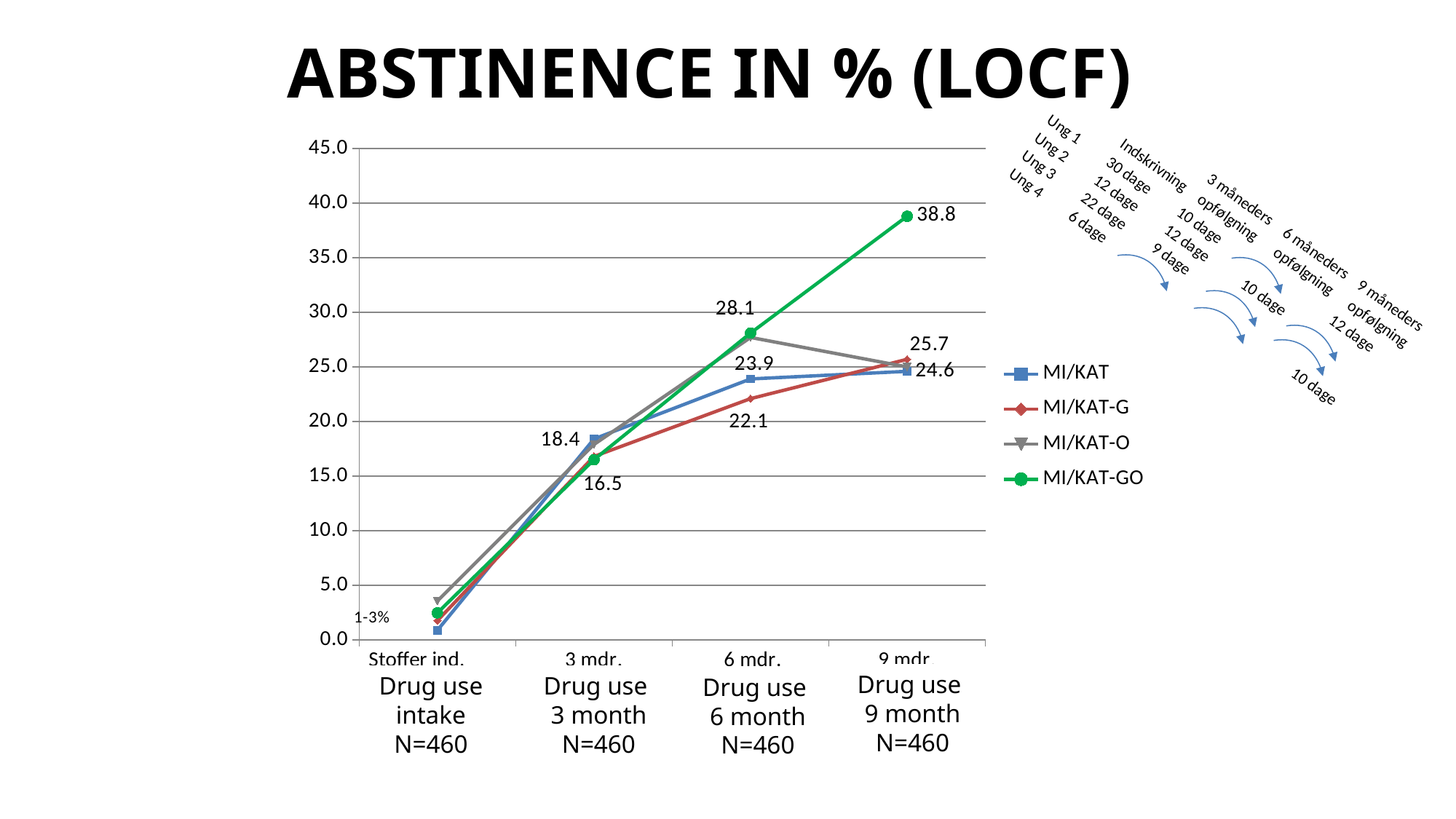
What kind of chart is shown on the slide? line chart Does the MI/KAT-GO series rise or fall from intake to 9 month? rise How many series does the legend list? 4 Is the value for MI/KAT-GO at Drug use 9 month greater or less than 35.0? greater Which series has the highest value at Drug use 9 month? MI/KAT-GO How many time points are plotted along the x axis? 4 What is the value for MI/KAT-GO at Drug use 9 month? 38.8 What is the value for MI/KAT-GO at Drug use 3 month? 16.5 What is the value for MI/KAT at Drug use 6 month? 23.9 What is the value for MI/KAT-G at Drug use 9 month? 25.7 What is the value for MI/KAT-G at Drug use 6 month? 22.1 What is the difference between MI/KAT-GO and MI/KAT-G at Drug use 9 month? 13.1